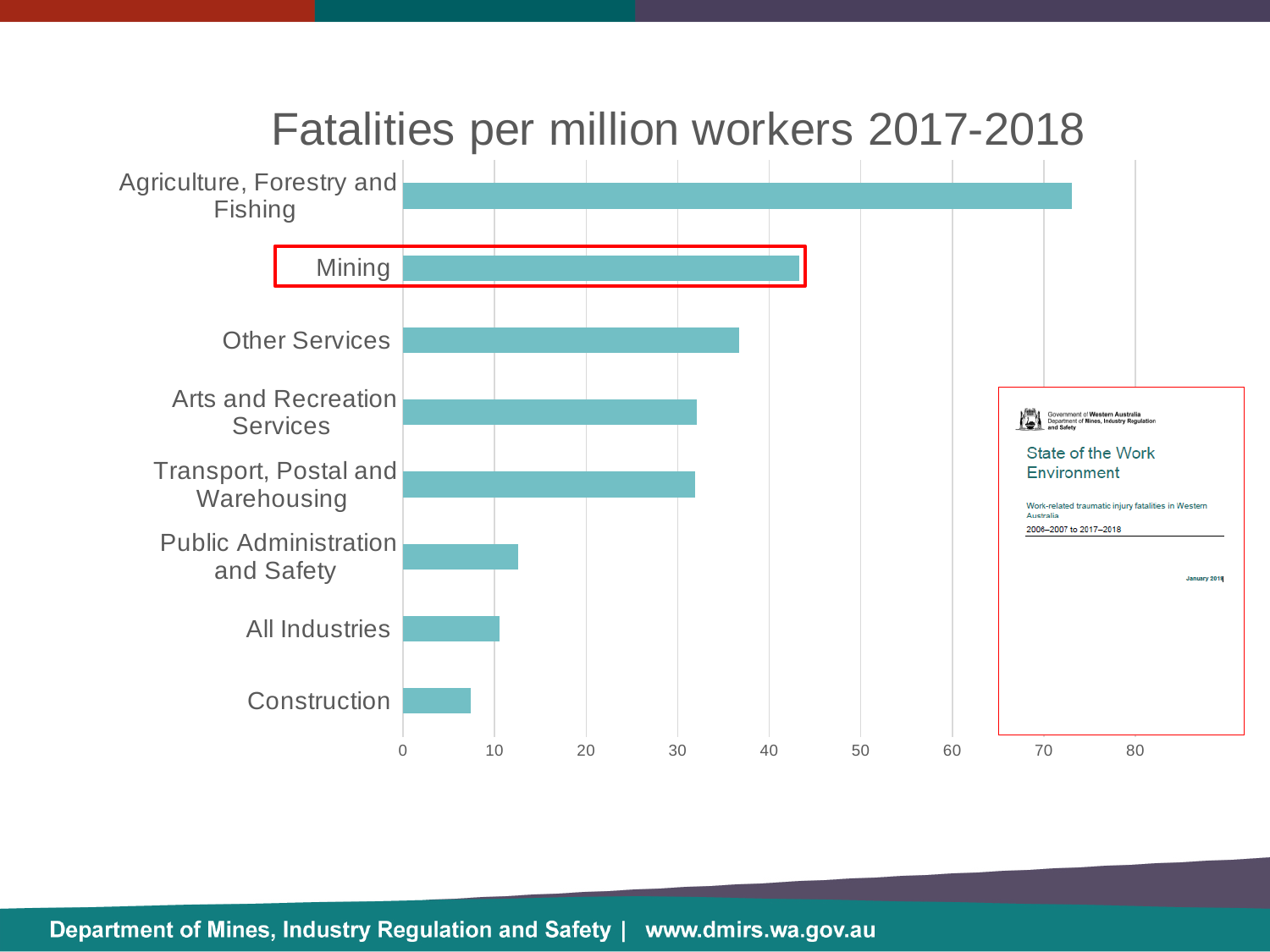
Is the value for Mining greater or less than 40? greater Is the value for Other Services greater or less than 40? less How many industry categories are plotted in the chart? 8 Which category has the highest fatalities per million workers? Agriculture, Forestry and Fishing Which has a higher value, Mining or Other Services? Mining Is the value for Agriculture, Forestry and Fishing greater or less than 70? greater Which category is highlighted with a red box on the chart? Mining What is the title of the chart? Fatalities per million workers 2017-2018 What kind of chart is shown on the slide? bar chart Which category has the lowest fatalities per million workers? Construction